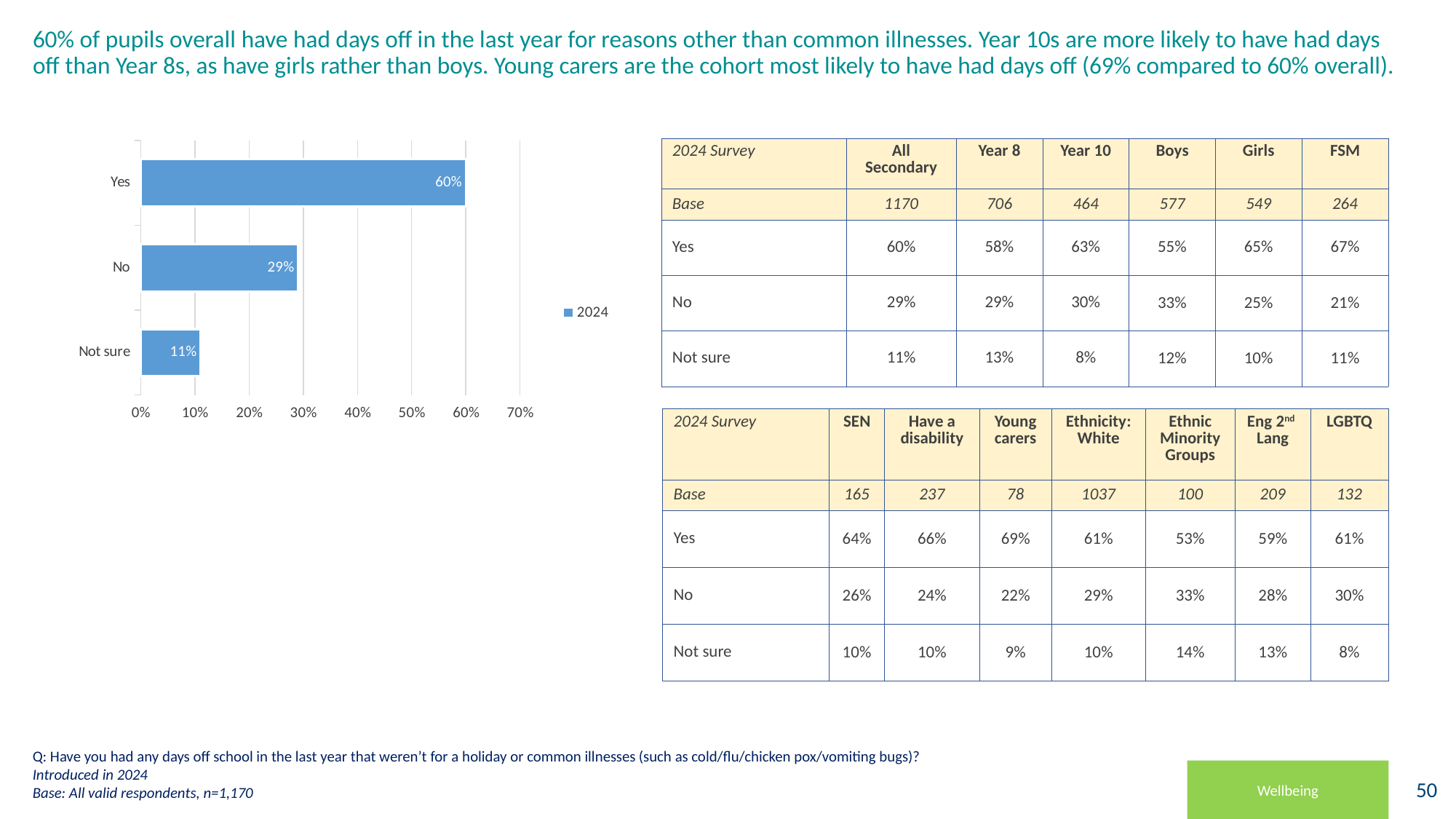
How many categories are shown in the bar chart? 3 Which category has the lowest value in the bar chart? Not sure Which is larger in the bar chart, the value for No or the value for Not sure? No What is the value for No in the bar chart? 29% What is the value for Not sure in the bar chart? 11% What is the value for Yes in the bar chart? 60% What is the difference between the values for Yes and No in the bar chart? 31% What is the difference between the values for No and Not sure in the bar chart? 18% How many series does the legend of the bar chart list? 1 Which category has the highest value in the bar chart? Yes Is the value for Yes in the bar chart greater or less than 50%? greater What kind of chart is shown on the slide? Bar chart